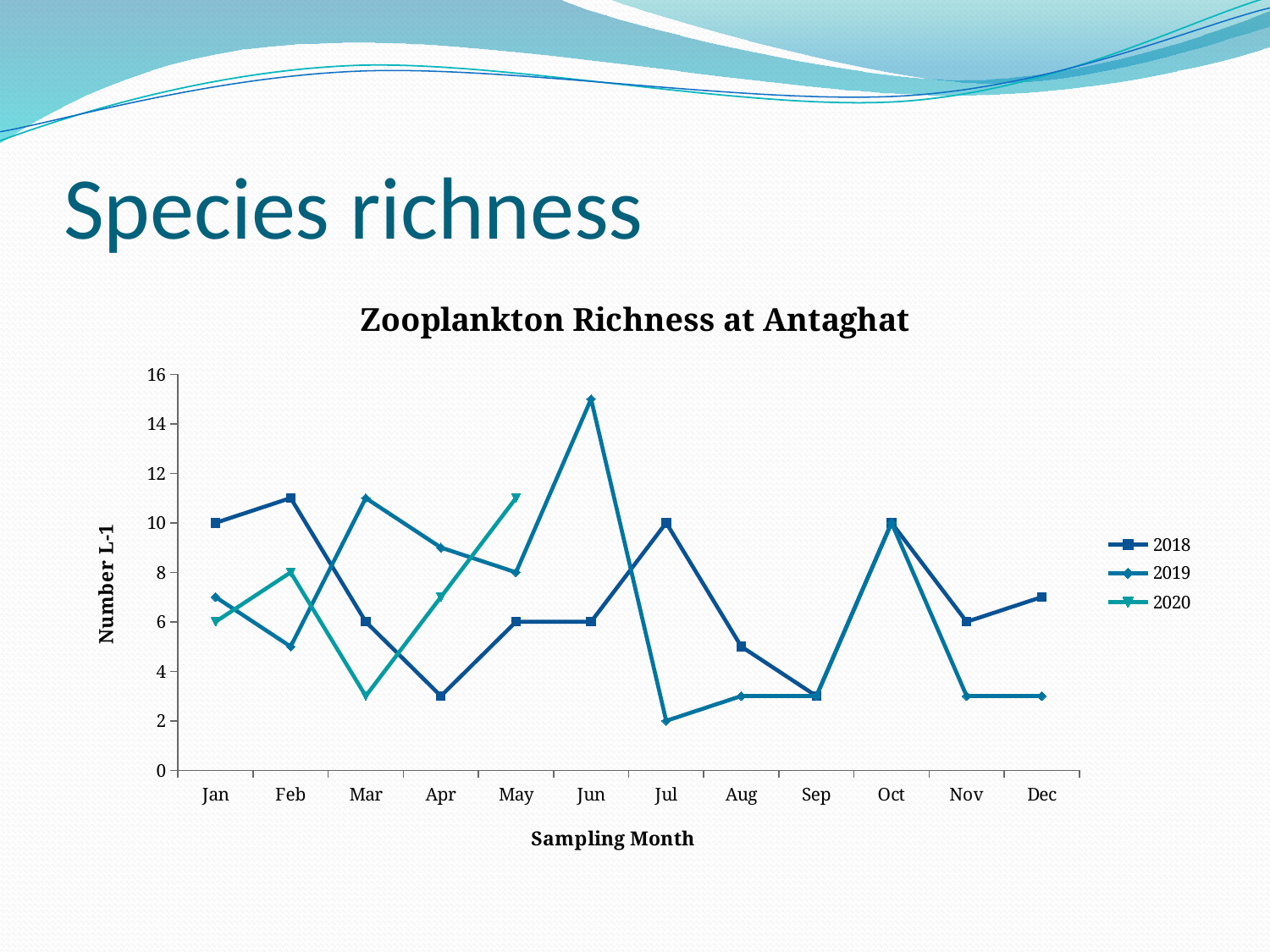
How many sampling months are shown on the x axis? 12 In which month does the 2019 series reach its highest value? Jun What is the title of the chart? Zooplankton Richness at Antaghat In which month does the 2019 series reach its lowest value? Jul Is the value for 2018 in Apr greater or less than 4? less What is the value for 2018 in Jan? 10 How many series does the legend list? 3 What kind of chart is shown on the slide? line chart Is the value for 2019 in Mar greater or less than 10? greater What is the value for 2019 in Jul? 2 Which is larger in Feb, the 2018 value or the 2019 value? 2018 What is the value for 2020 in Feb? 8